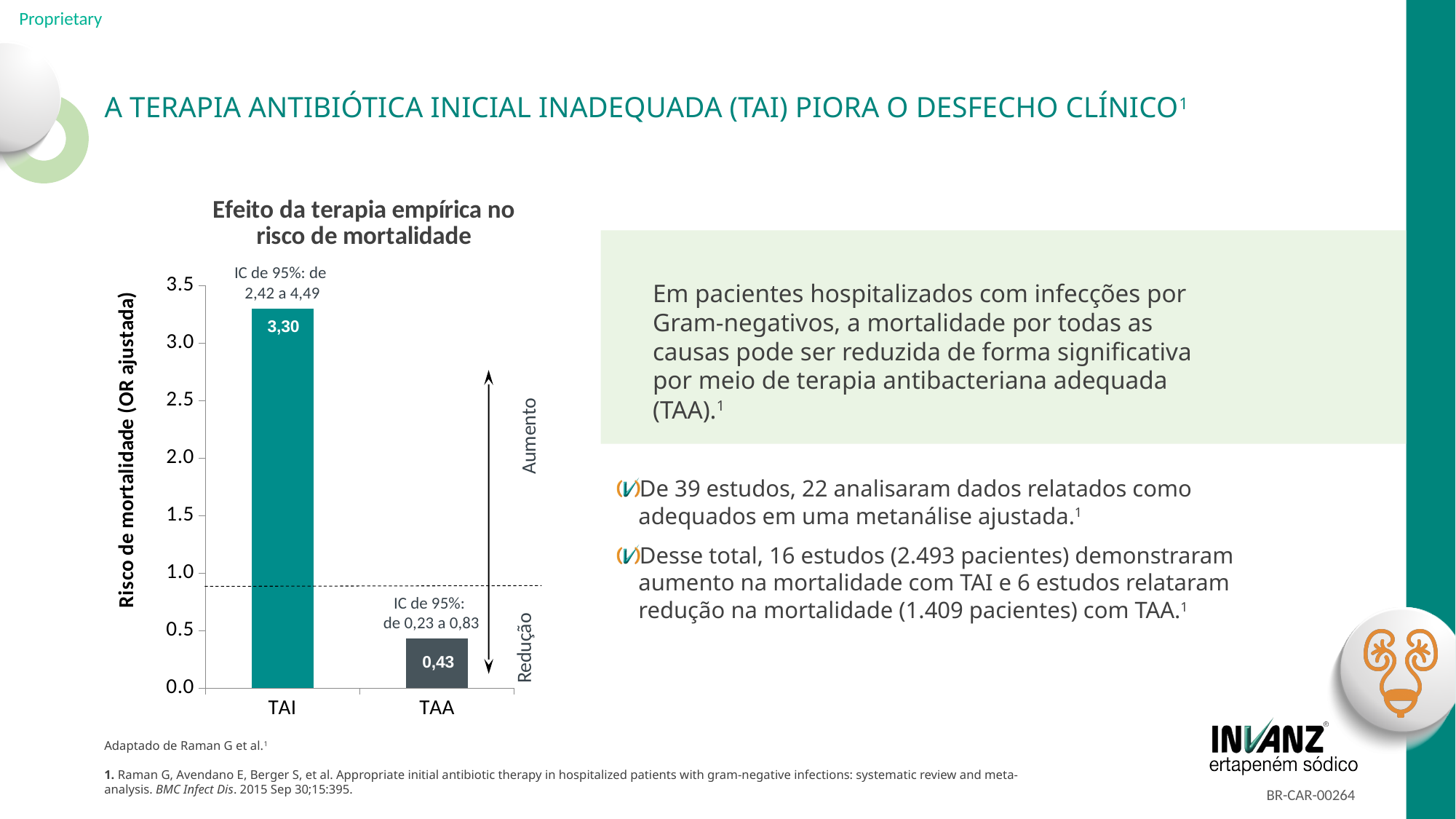
What is the adjusted mortality risk (OR) value shown for TAA? 0,43 How many categories are plotted on the x axis? 2 What is the 95% confidence interval shown for TAI? 2,42 a 4,49 What is the adjusted mortality risk (OR) value shown for TAI? 3,30 Which category has the lowest mortality risk value? TAA Which category has the higher mortality risk, TAI or TAA? TAI What is the difference between the mortality risk values for TAI and TAA? 2,87 What is the 95% confidence interval shown for TAA? 0,23 a 0,83 What kind of chart is shown on the slide? bar chart Is the value for TAI greater or less than 3.0? greater Is the value for TAA greater or less than 0.5? less What is the title of the chart? Efeito da terapia empírica no risco de mortalidade